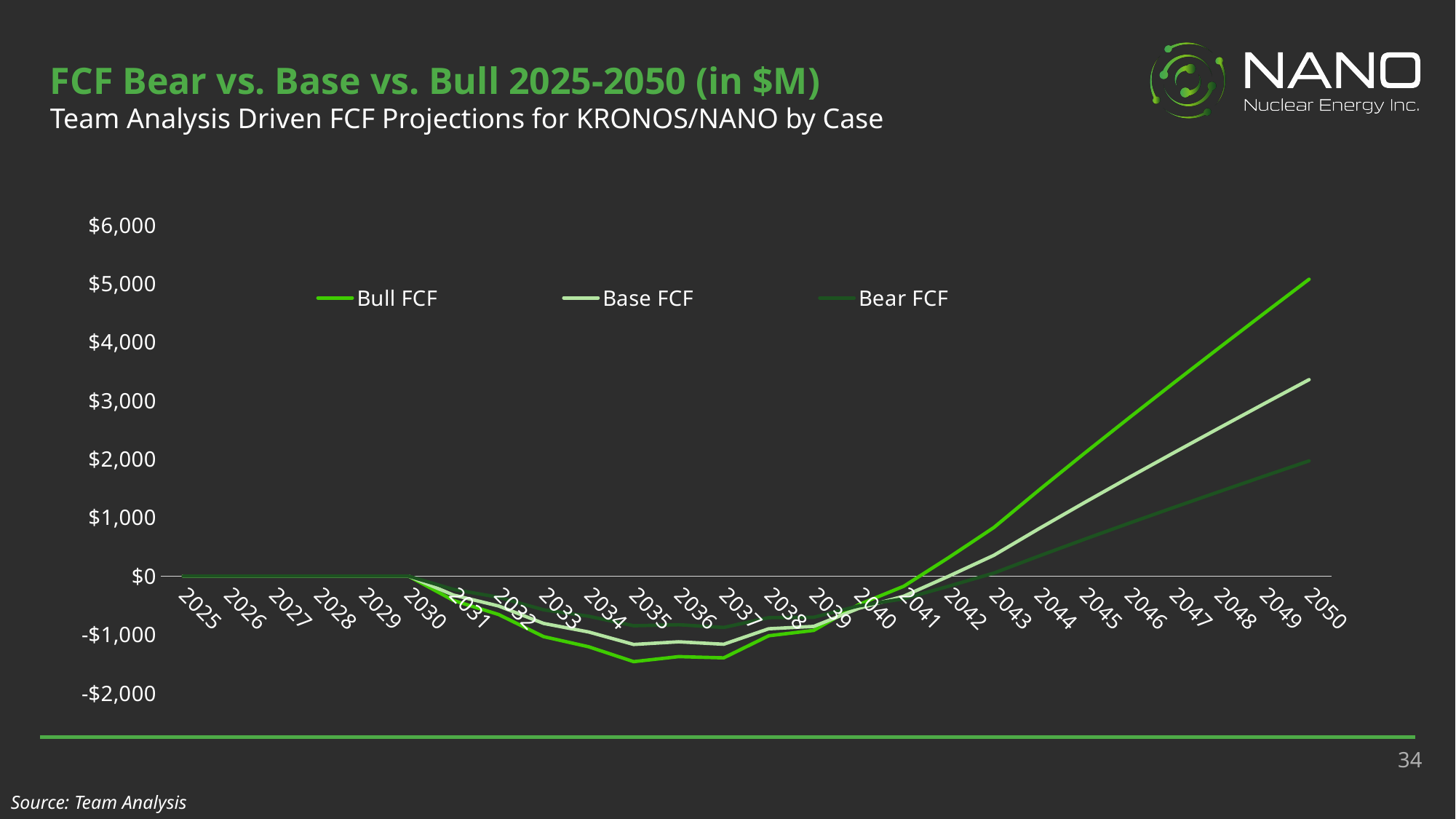
Which series has the highest value in 2050? Bull FCF Is the value for Bull FCF in 2050 greater or less than $4,000? greater In 2035, which is larger: Bear FCF or Bull FCF? Bear FCF Is the value for Base FCF in 2050 greater or less than $3,000? greater What kind of chart is shown on the slide? Line chart Is the value for Bull FCF in 2035 greater or less than -$1,000? less Which series has the lowest value in 2035? Bull FCF Does Bull FCF rise or fall from 2042 to 2050? Rise What is the title of the chart? FCF Bear vs. Base vs. Bull 2025-2050 (in $M) How many series does the legend list? 3 How many years are plotted along the x axis? 26